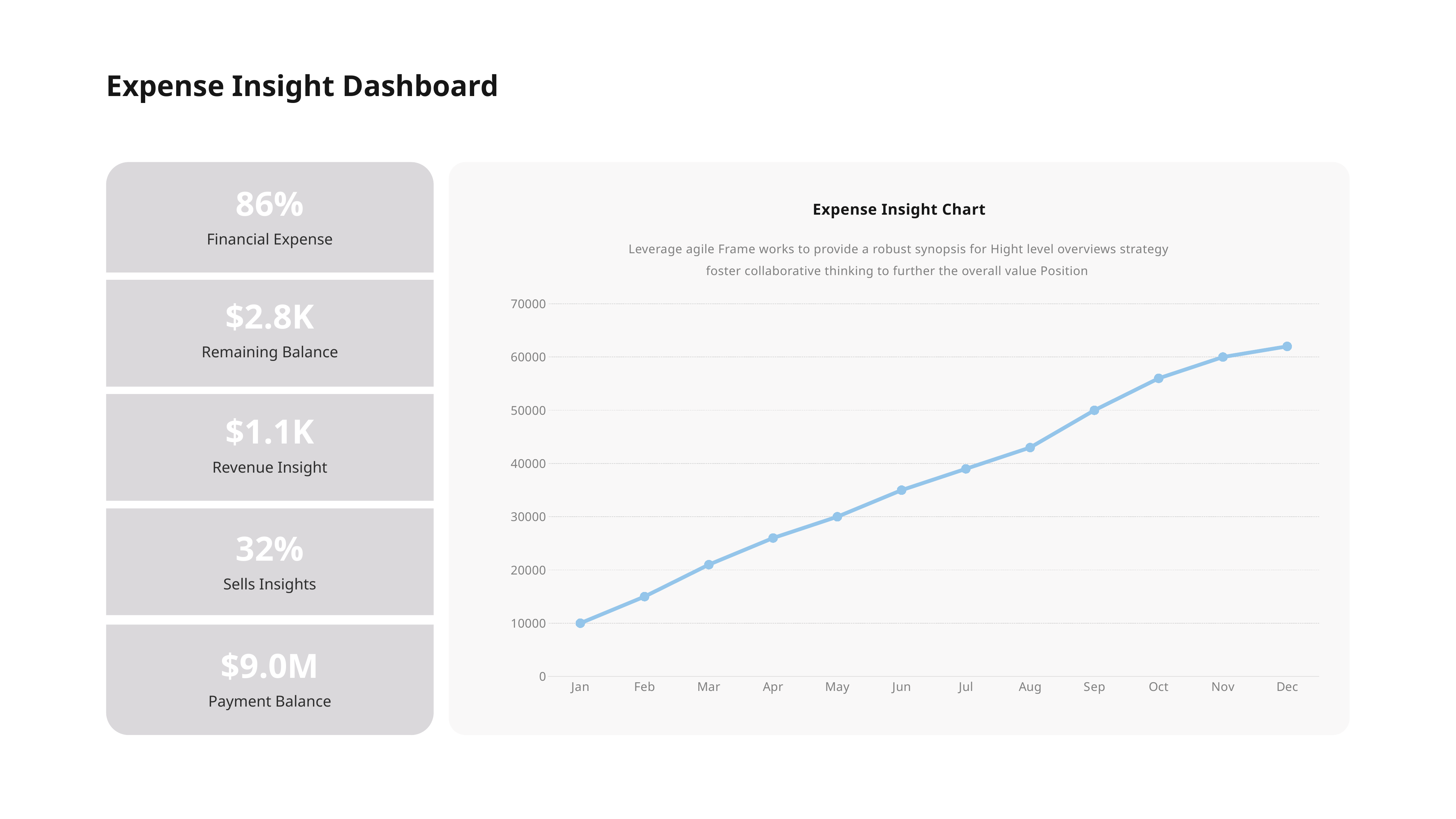
How many months are plotted on the x axis of the Expense Insight Chart? 12 Do the values in the Expense Insight Chart rise or fall from Jan to Dec? rise What is the value for May in the Expense Insight Chart? 30000 Is the value for Aug in the Expense Insight Chart greater or less than 40000? greater Is the value for Mar in the Expense Insight Chart greater or less than 30000? less Which month has the highest value in the Expense Insight Chart? Dec What is the value for Nov in the Expense Insight Chart? 60000 Which month has the lowest value in the Expense Insight Chart? Jan What is the value for Jan in the Expense Insight Chart? 10000 What kind of chart is the Expense Insight Chart? line chart In the Expense Insight Chart, which is larger, the value for Oct or the value for Apr? Oct What is the value for Sep in the Expense Insight Chart? 50000